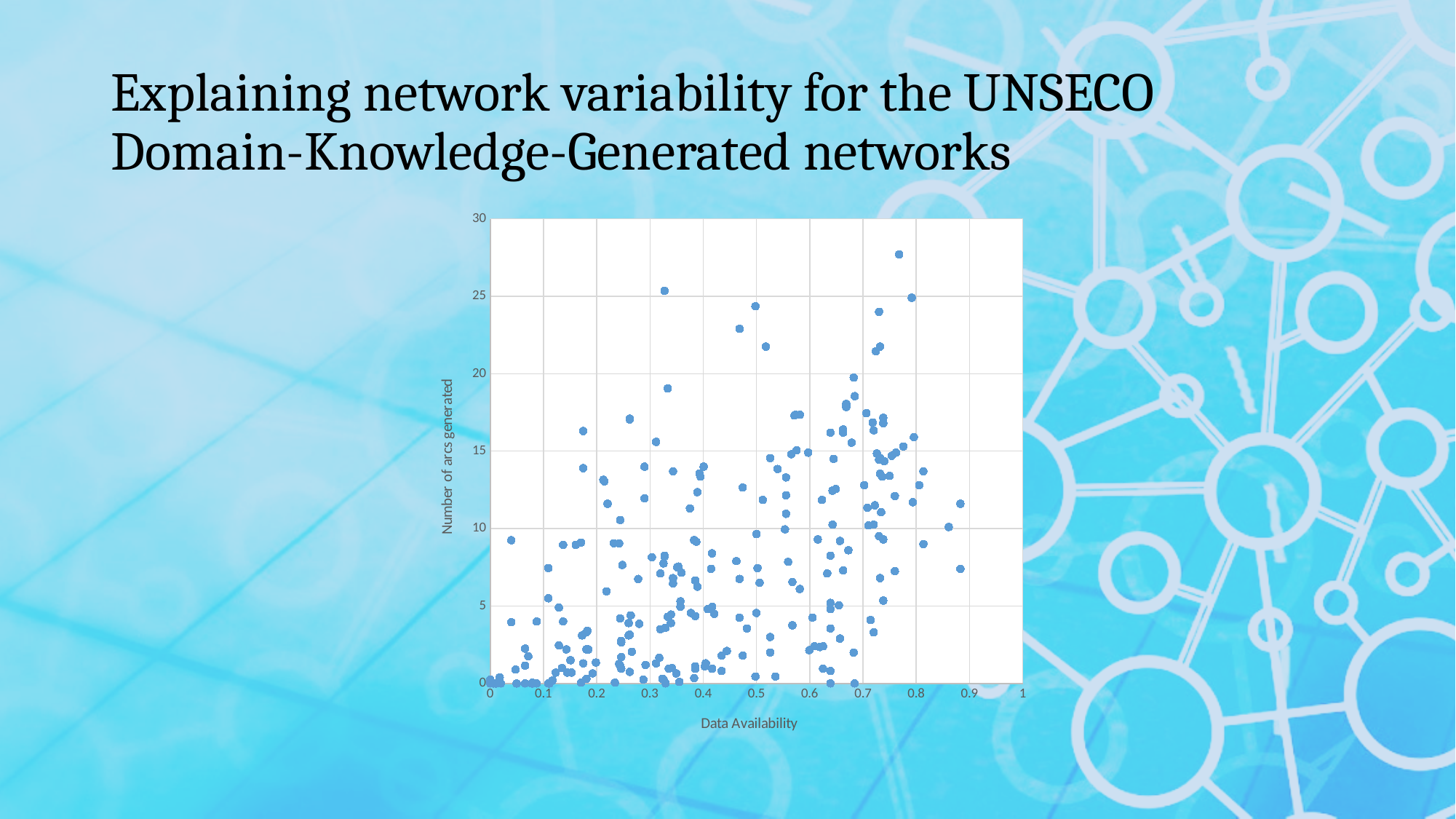
Is the highest point on the chart greater or less than 25 on the y axis? greater What kind of chart is shown on the slide? scatter plot Is the highest point on the chart greater or less than 30 on the y axis? less What is the label of the y axis of the chart? Number of arcs generated Overall, do the number of arcs generated tend to rise or fall as data availability increases? rise How many data series are plotted on the chart? 1 What is the label of the x axis of the chart? Data Availability Do the points on the chart extend beyond 0.9 on the x axis? No